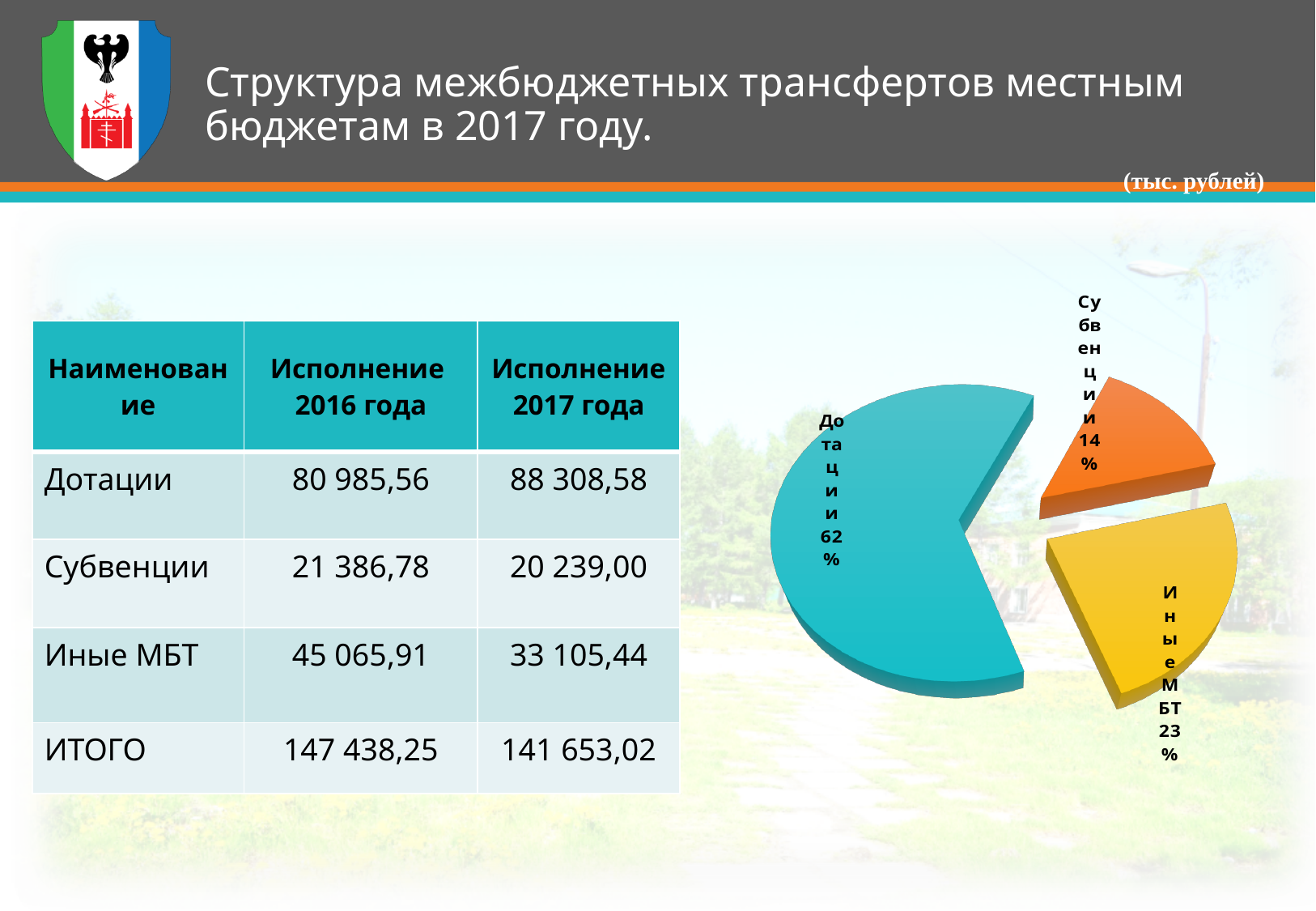
What colour is the Дотации slice in the pie chart? teal What share of the pie chart does Иные МБТ represent? 23% In the pie chart, what is the difference in percentage points between Дотации and Субвенции? 48 In the pie chart, which is larger: Иные МБТ or Субвенции? Иные МБТ What share of the pie chart does Дотации represent? 62% How many slices does the pie chart have? 3 What colour is the Субвенции slice in the pie chart? orange Which slice of the pie chart is the largest? Дотации What share of the pie chart does Субвенции represent? 14% What kind of chart is shown on the slide? pie chart Which slice of the pie chart is the smallest? Субвенции In the pie chart, what is the difference in percentage points between Иные МБТ and Субвенции? 9